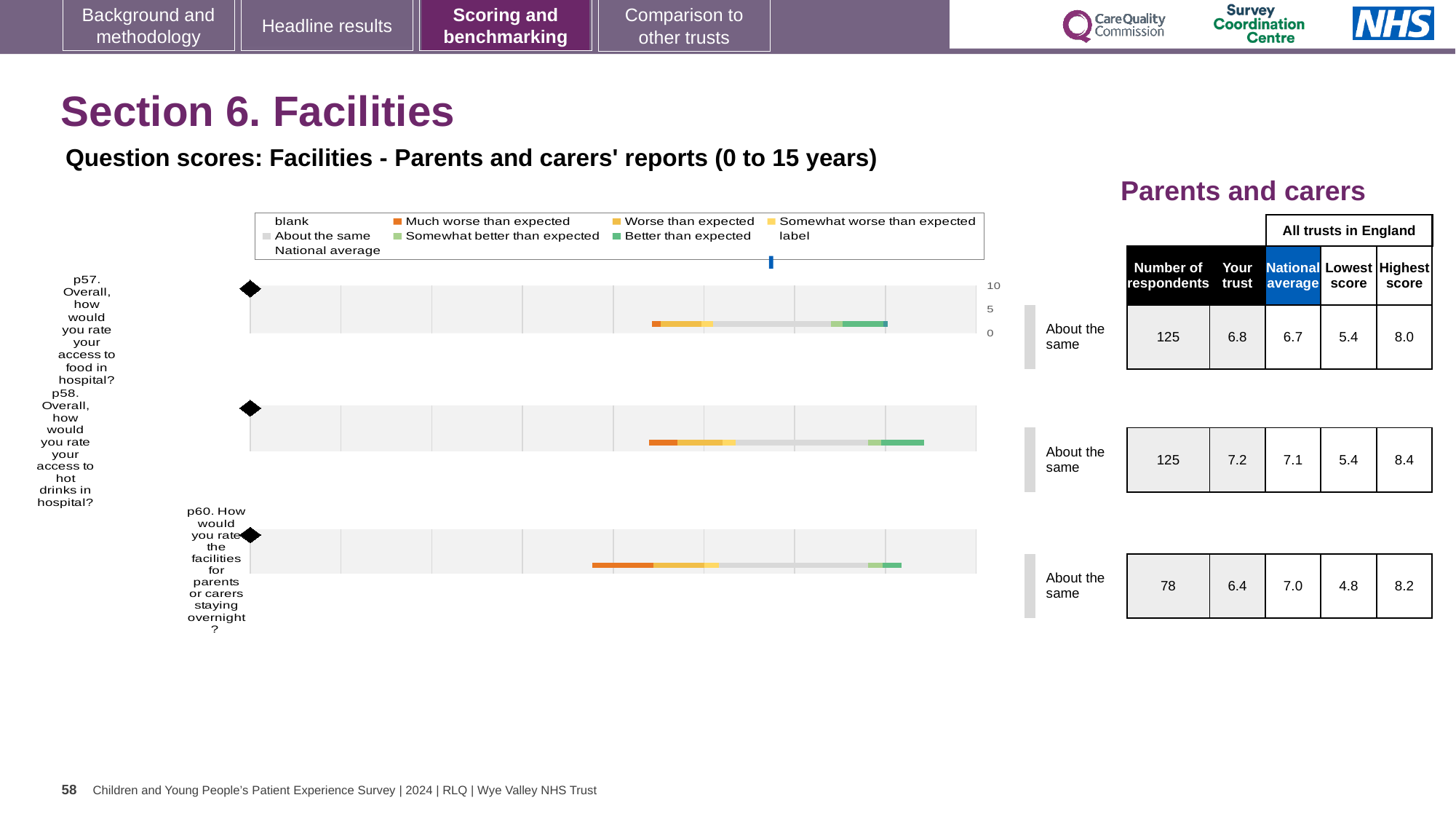
For p58, what is the difference between the highest score and the lowest score across all trusts in England? 3.0 What is the subtitle above the charts describing the question scores? Question scores: Facilities - Parents and carers' reports (0 to 15 years) For p60, how much higher is the national average than the 'Your trust' score? 0.6 How many question charts (p57, p58, p60) are shown on the slide? 3 What kind of chart is used to show the question scores for p57, p58 and p60? bar chart Which question has the lowest 'Your trust' score? p60 What is the 'Your trust' score for p57 (access to food in hospital)? 6.8 How many respondents answered p60 (facilities for parents or carers staying overnight)? 78 What is the national average score for p58 (access to hot drinks in hospital)? 7.1 Which question has the highest 'Your trust' score? p58 For p60, is the 'Your trust' score or the national average higher? National average What benchmark category is shown for p57? About the same